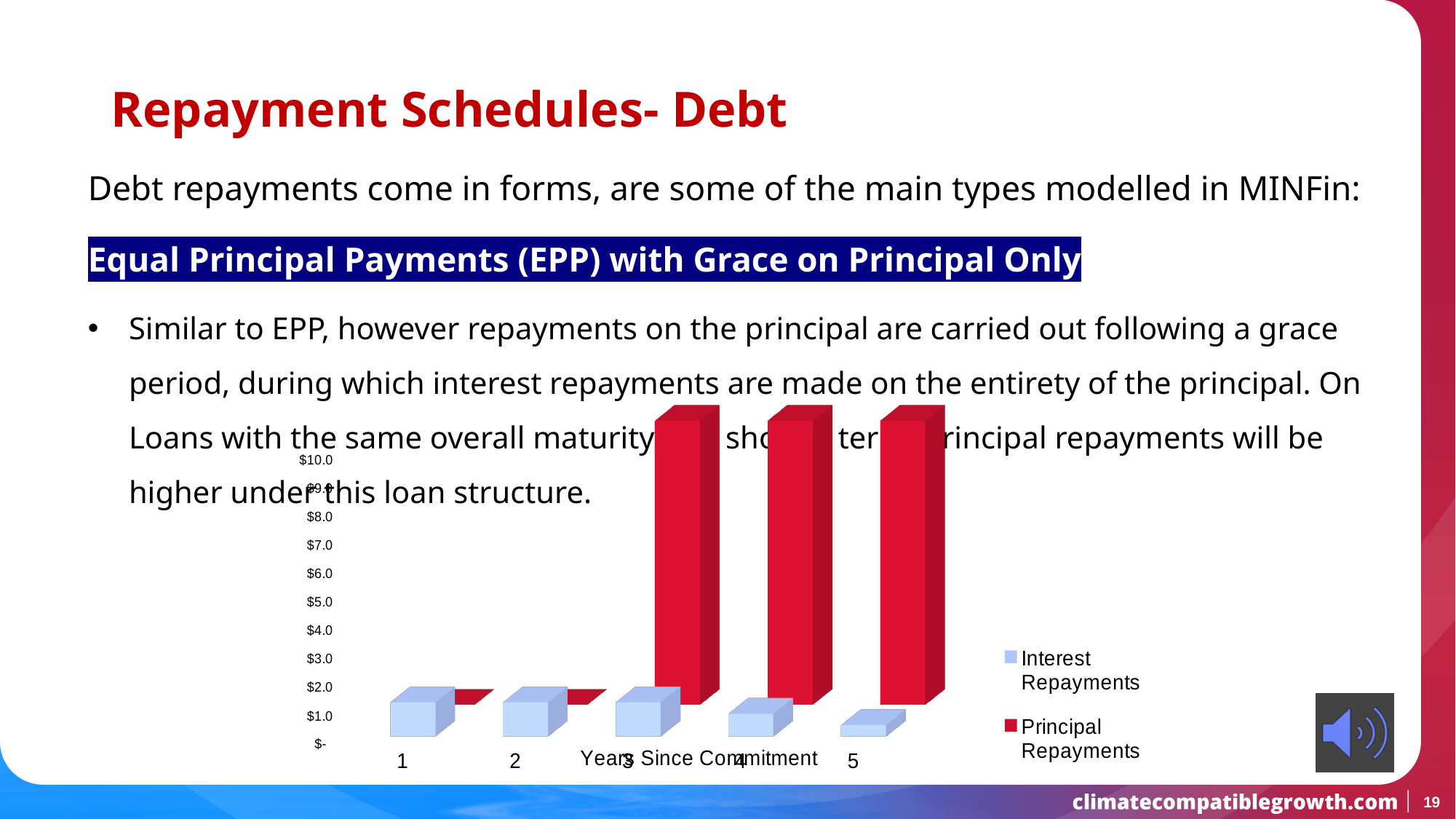
What is the title of the x axis of the chart? Years Since Commitment Is the value for Principal Repayments in year 3 greater or less than $5.0? greater Which is larger: Principal Repayments in year 3 or Principal Repayments in year 1? Principal Repayments in year 3 Is the value for Principal Repayments in year 1 greater or less than $1.0? less How many series does the chart legend list? 2 Which series is shown in red in the chart? Principal Repayments Is the value for Interest Repayments in year 1 greater or less than $3.0? less Do Interest Repayments rise or fall from year 1 to year 5? fall How many years are shown along the x axis of the chart? 5 In which year are Interest Repayments lowest? 5 What kind of chart is shown on the slide? bar chart Which is larger in year 4: Interest Repayments or Principal Repayments? Principal Repayments